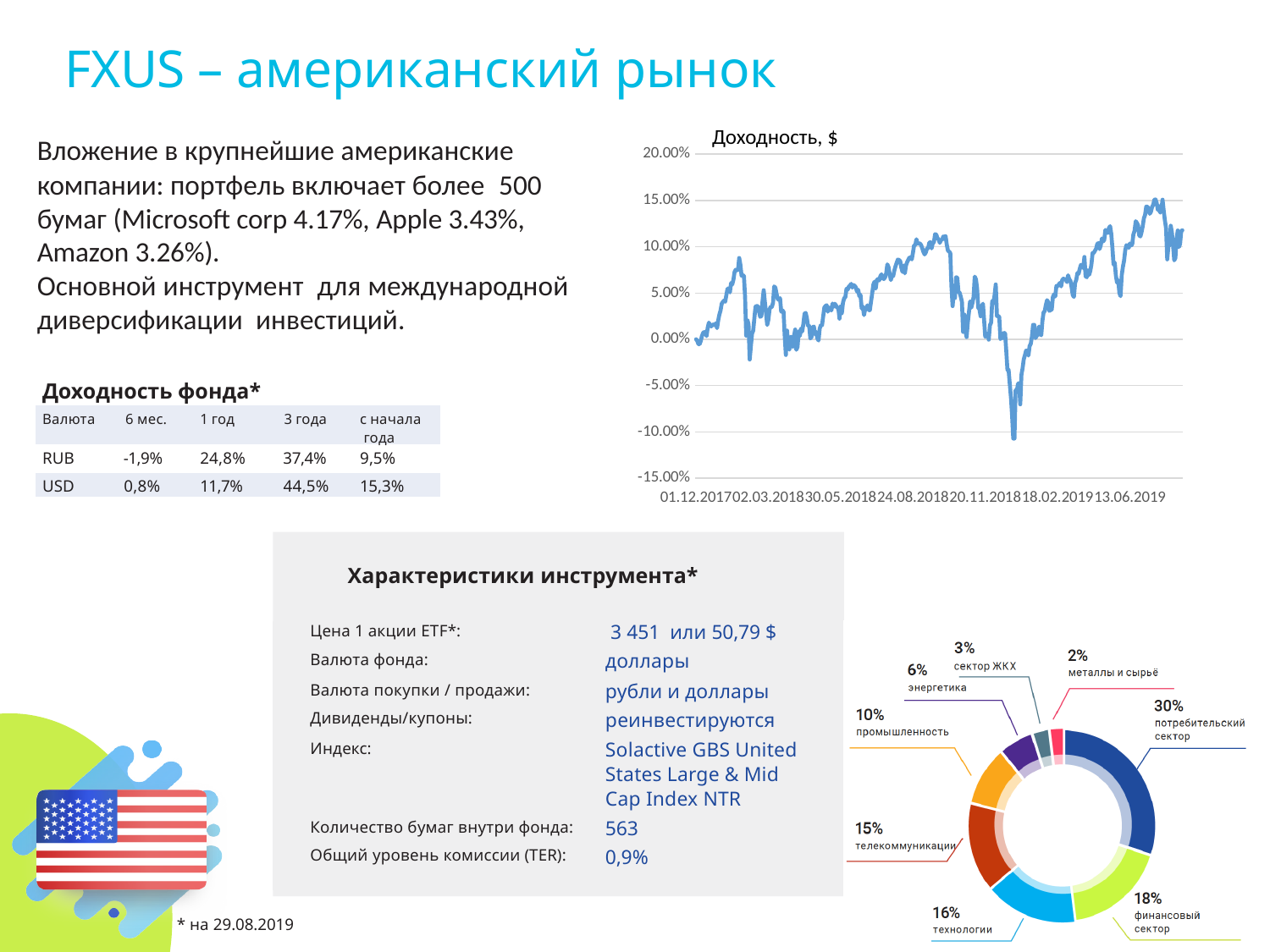
What kind of chart is the sector allocation chart in the bottom right of the slide? donut (pie) chart In the donut chart in the bottom right, what share does потребительский сектор have? 30% In the donut chart in the bottom right, what share does энергетика have? 6% In the chart titled "Доходность, $", is the value at the right end of the line greater or less than 10.00%? greater In the chart titled "Доходность, $", do the values overall rise or fall from the start of the x axis to the end? rise In the donut chart in the bottom right, which sector has the largest share? потребительский сектор In the donut chart in the bottom right, how many sectors are labelled? 8 How many date labels are shown on the x axis of the chart titled "Доходность, $"? 7 What kind of chart is the chart titled "Доходность, $" in the top right of the slide? line chart In the chart titled "Доходность, $", is the lowest point of the line greater or less than -5.00%? less In the donut chart in the bottom right, what is the difference between the shares of финансовый сектор and технологии? 2% In the donut chart in the bottom right, which sector has the smallest share? металлы и сырьё